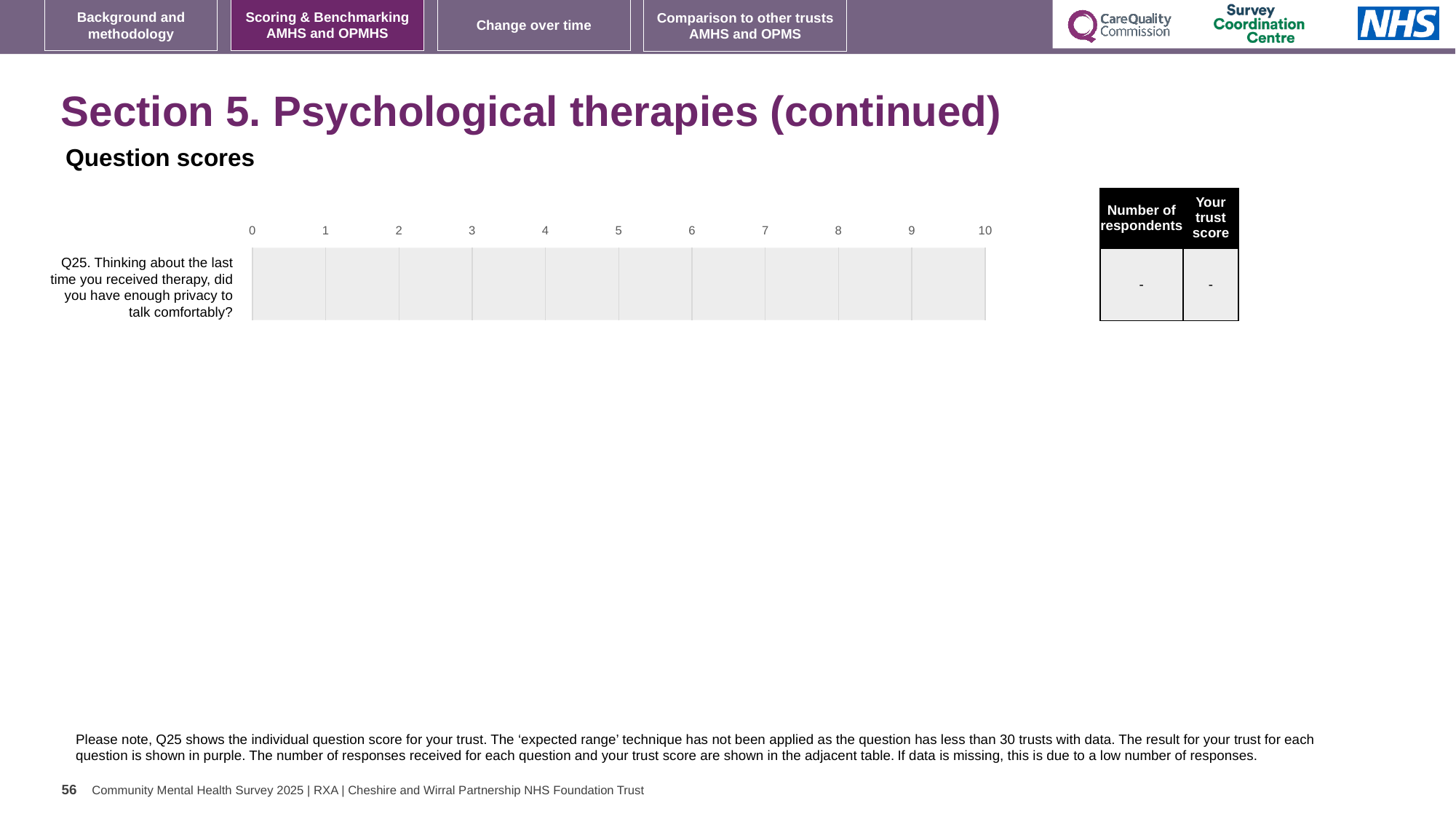
Is a bar plotted for Q25 on the chart? No Which question number is plotted on the chart? Q25 How many questions (categories) are plotted on the chart? 1 What is the 'Your trust score' value shown in the table for Q25? - What is the 'Number of respondents' value shown in the table for Q25? - What is the highest value shown on the chart's x axis? 10 What is the lowest value shown on the chart's x axis? 0 What kind of chart is shown on the slide? bar chart